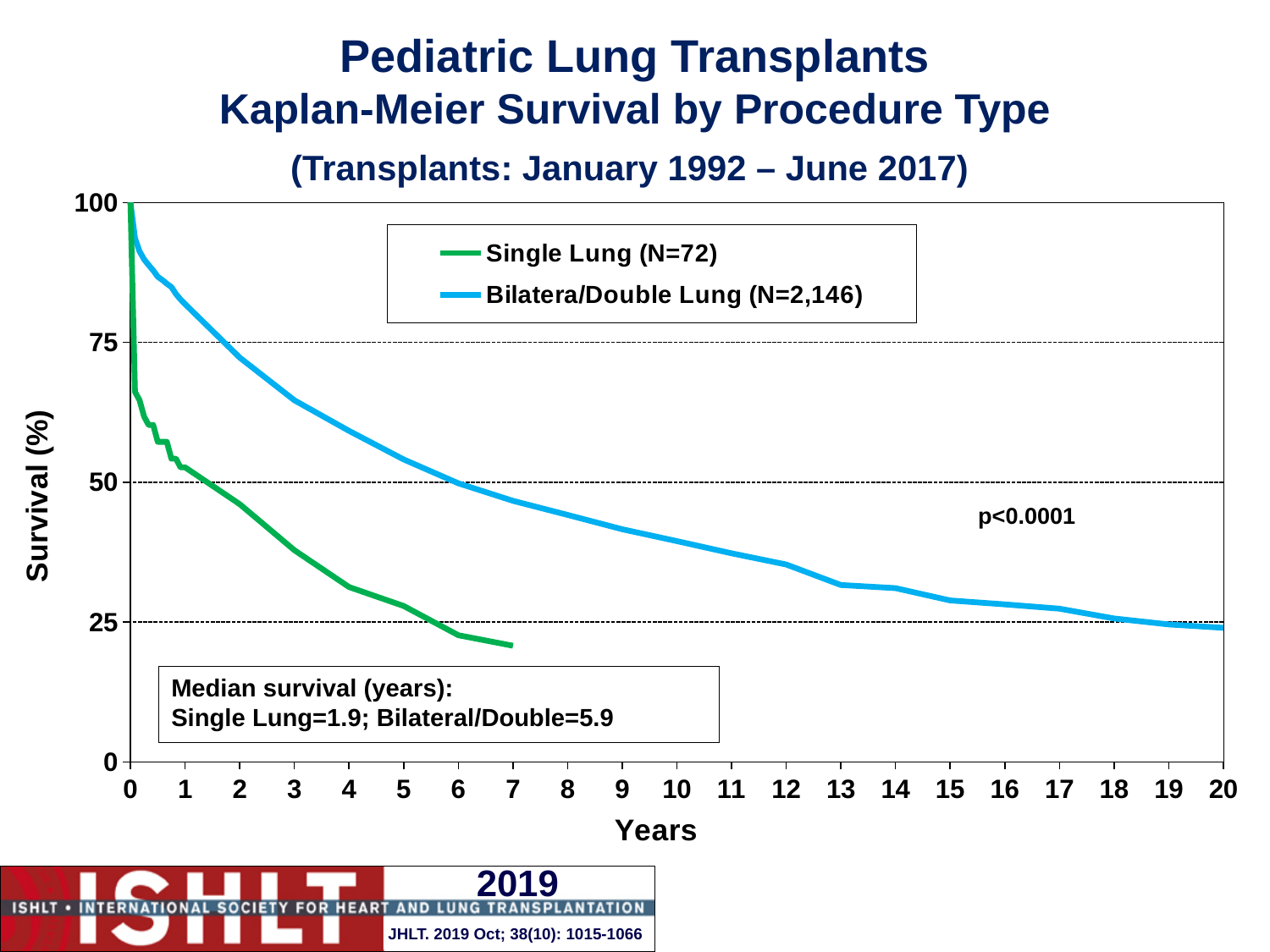
What is the median survival in years for Single Lung transplants? 1.9 What is the N for the Bilateral/Double Lung group shown in the legend? 2,146 What is the median survival in years for Bilateral/Double lung transplants? 5.9 Do the survival curves rise or fall as years increase? fall How many series does the legend list? 2 What p-value is printed on the chart? p<0.0001 At 5 years, which group has the higher survival, Single Lung or Bilateral/Double Lung? Bilateral/Double Lung Is the survival for Bilateral/Double Lung at 1 year greater or less than 75? greater What kind of chart is shown on the slide? line chart What is the N for the Single Lung group shown in the legend? 72 Is the survival for Bilateral/Double Lung at 10 years greater or less than 50? less Is the survival for Single Lung at 4 years greater or less than 50? less